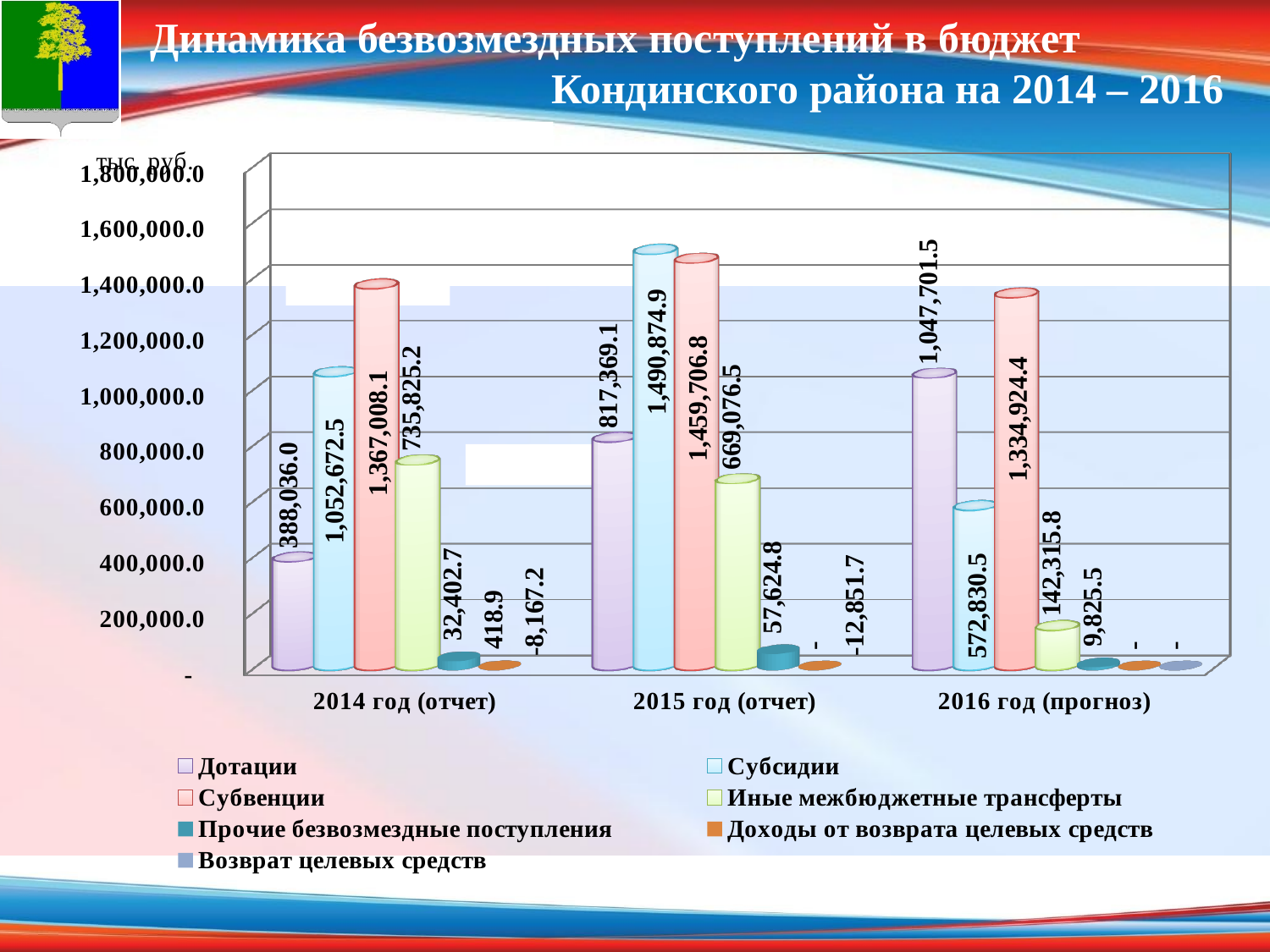
In which year is the value for Дотации the lowest? 2014 год (отчет) How many year categories are shown on the x axis? 3 What is the value for Возврат целевых средств in 2015 год (отчет)? -12,851.7 In 2015 год (отчет), which is larger: Субсидии or Субвенции? Субсидии In which year is the value for Субсидии the highest? 2015 год (отчет) Do the values for Дотации rise or fall from 2014 to 2016? Rise What is the value for Субсидии in 2015 год (отчет)? 1,490,874.9 What kind of chart is shown on the slide? Bar chart What is the value for Дотации in 2016 год (прогноз)? 1,047,701.5 How many series does the legend list? 7 What is the value for Субвенции in 2014 год (отчет)? 1,367,008.1 By how much does the value for Субвенции in 2015 год (отчет) exceed the value in 2014 год (отчет)? 92,698.7